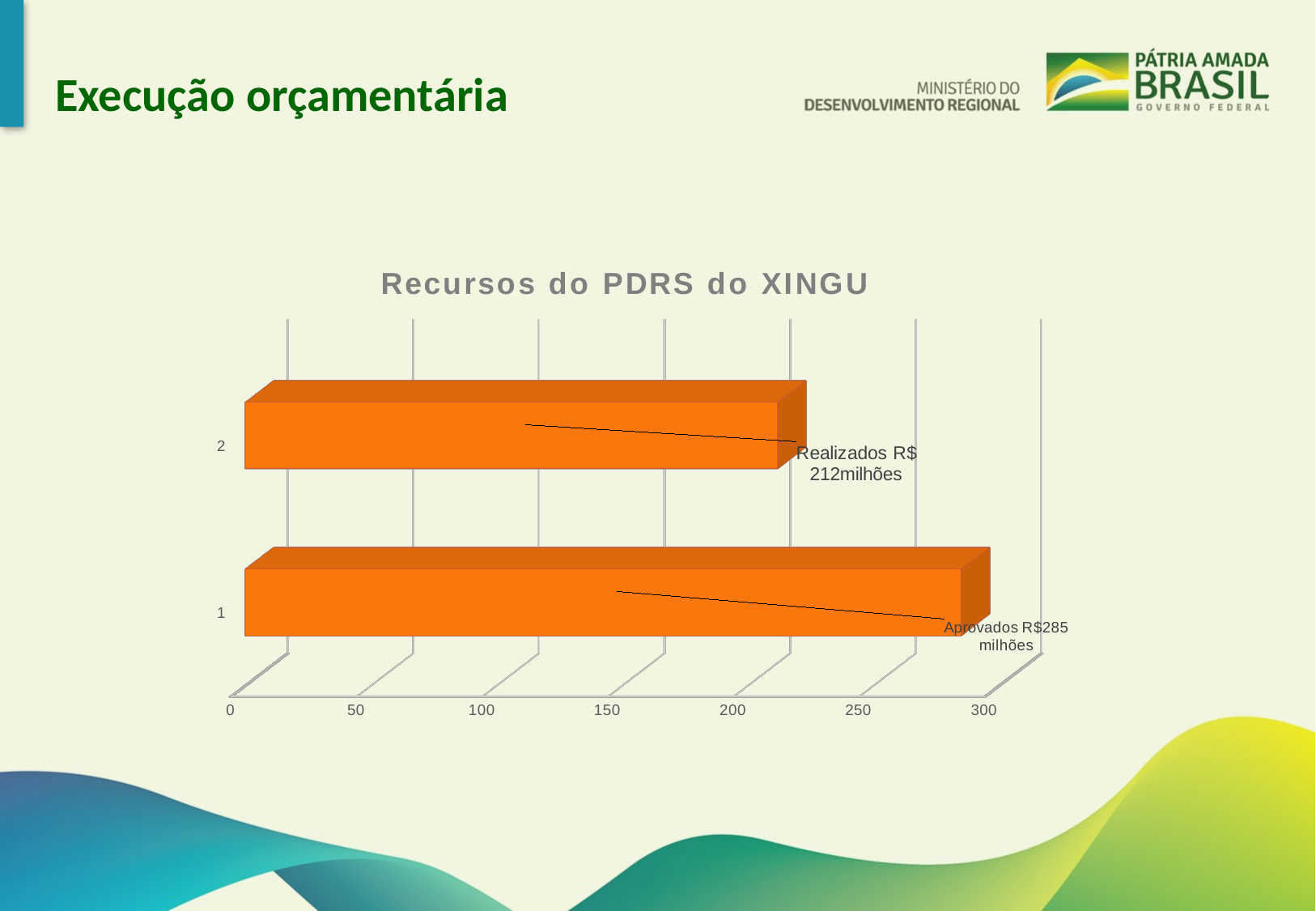
Is the value for 'Aprovados' greater or less than 250? greater What kind of chart is shown on the slide? bar chart Which bar has the lowest value? Realizados Which bar has the highest value? Aprovados What is the title of the chart? Recursos do PDRS do XINGU Is the value for 'Realizados' greater or less than 250? less What value is labelled on the bar for 'Aprovados'? R$285 milhões What value is labelled on the bar for 'Realizados'? R$ 212milhões What is the maximum value shown on the horizontal axis? 300 Which bar is longer, 'Aprovados' or 'Realizados'? Aprovados What is the difference in millions between the 'Aprovados' and 'Realizados' values? 73 How many bars does the chart show? 2